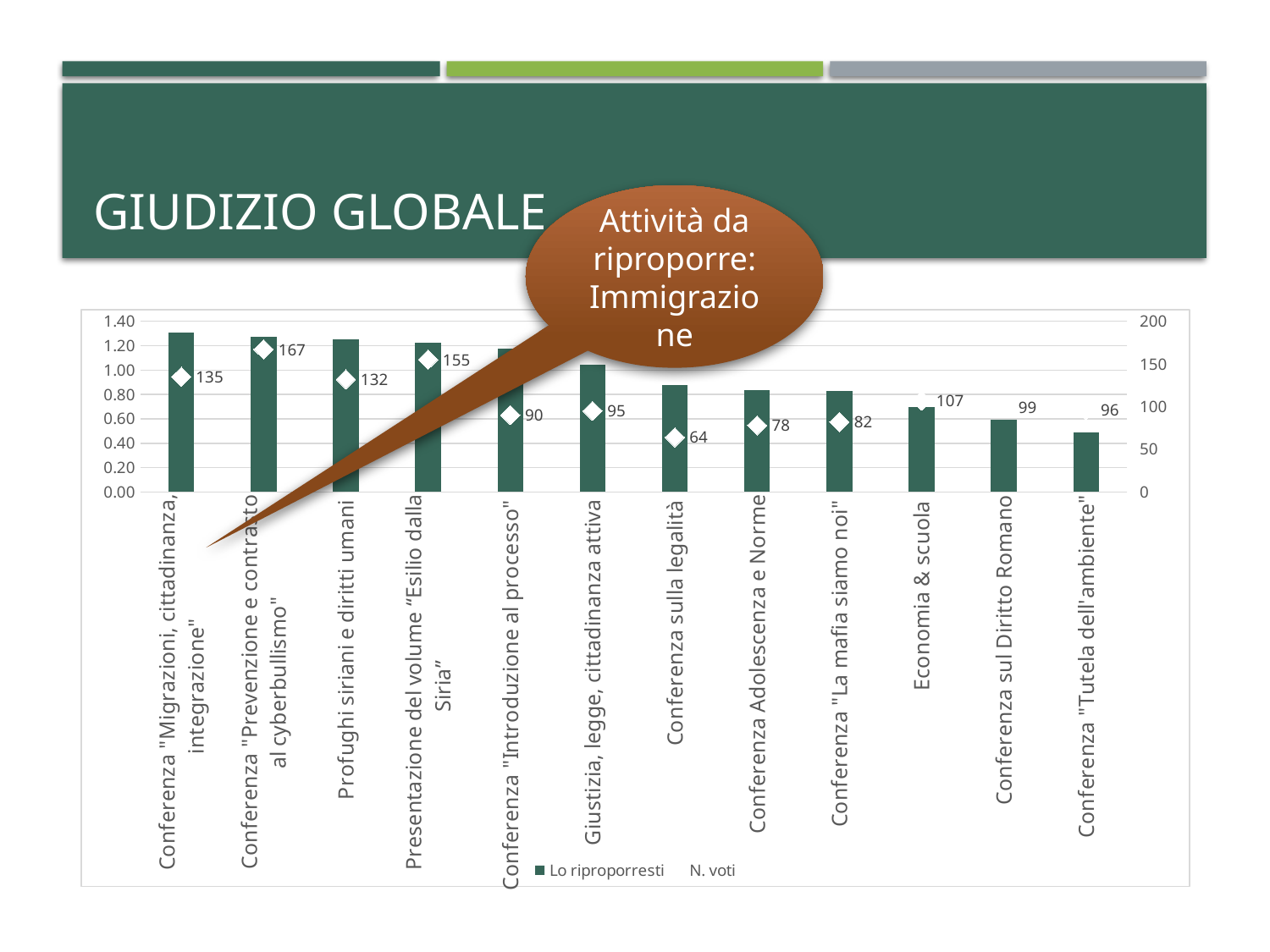
Do the Lo riproporresti bars generally rise or fall from left to right along the x axis? fall Is the Lo riproporresti value for Conferenza "Migrazioni, cittadinanza, integrazione" greater or less than 1.20? greater Which has a higher N. voti value: Presentazione del volume "Esilio dalla Siria" or Profughi siriani e diritti umani? Presentazione del volume "Esilio dalla Siria" What is the N. voti value for Economia & scuola? 107 What is the difference in N. voti between Conferenza "Prevenzione e contrasto al cyberbullismo" and Conferenza "Migrazioni, cittadinanza, integrazione"? 32 Is the Lo riproporresti value for Conferenza "Tutela dell'ambiente" greater or less than 0.60? less What is the N. voti value for Conferenza sulla legalità? 64 Which category has the lowest N. voti value? Conferenza sulla legalità How many categories are shown on the x axis of the chart? 12 Which category has the highest N. voti value? Conferenza "Prevenzione e contrasto al cyberbullismo" What is the N. voti value for Conferenza "Prevenzione e contrasto al cyberbullismo"? 167 How many series does the chart legend list? 2